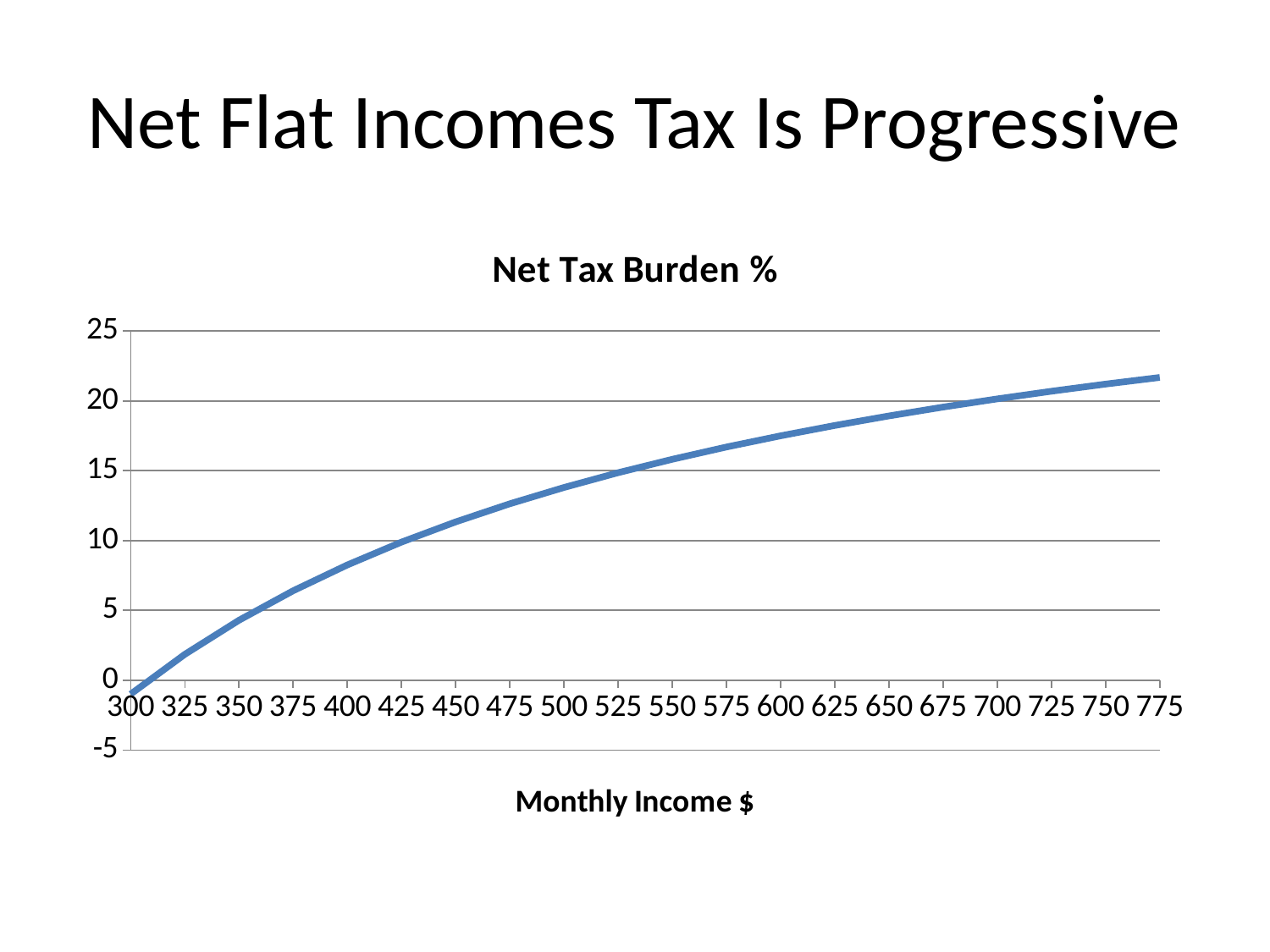
Does the net tax burden rise or fall as monthly income increases from 300 to 775? rise Is the net tax burden at a monthly income of 400 greater or less than 10? less At which monthly income is the net tax burden lowest? 300 What is the title of the chart? Net Tax Burden % How many monthly income values are labelled on the x axis? 20 At which monthly income is the net tax burden highest? 775 What is the label of the x axis? Monthly Income $ Is the net tax burden at a monthly income of 300 greater or less than 0? less Is the net tax burden at a monthly income of 500 greater or less than 10? greater What kind of chart is shown on the slide? line chart Which is larger, the net tax burden at a monthly income of 450 or at 650? 650